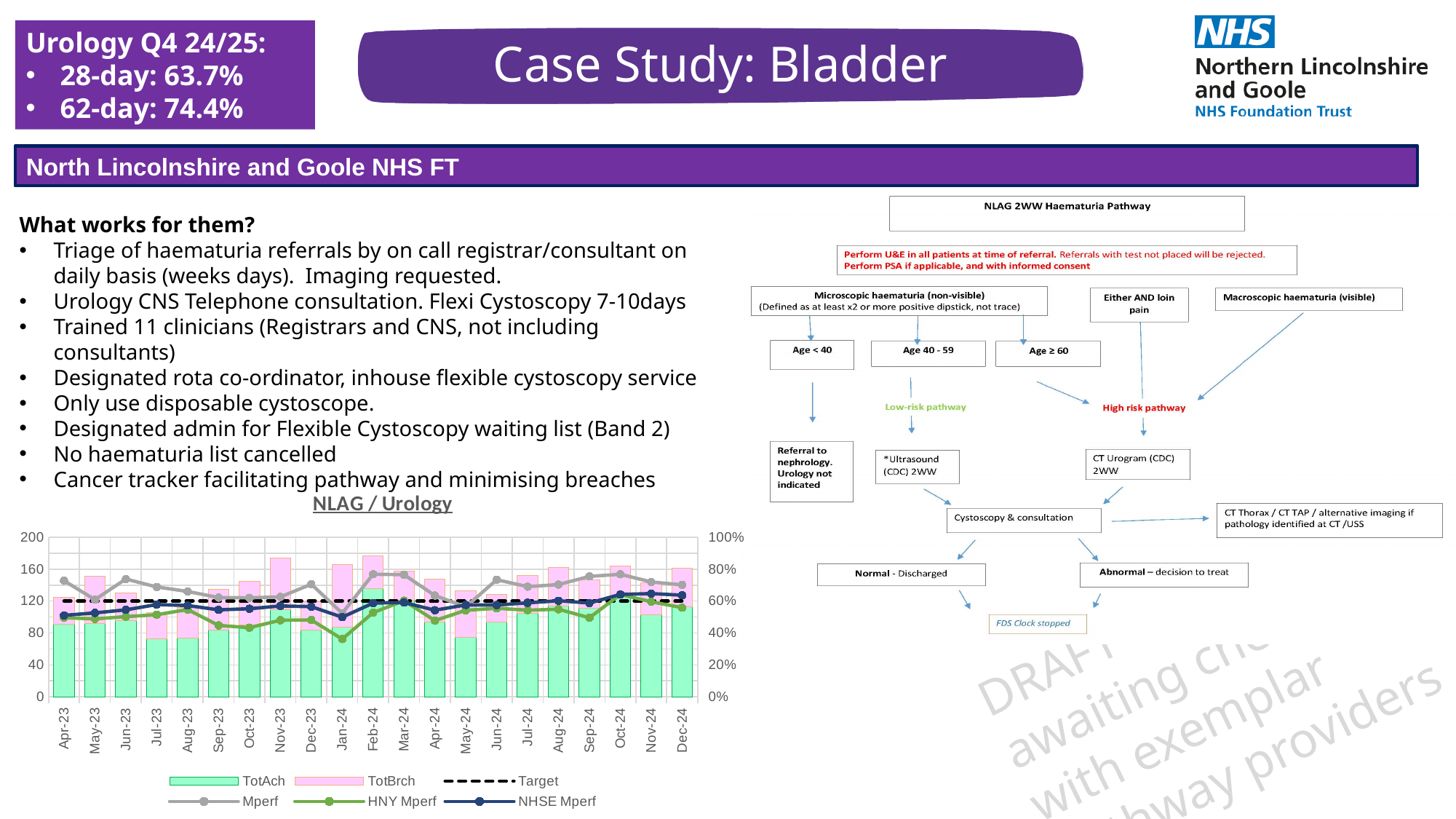
Which month is the last category on the x axis of the NLAG / Urology chart? Dec-24 How is the Target series drawn in the NLAG / Urology chart? As a black dashed line Is the total stacked bar (TotAch plus TotBrch) for Nov-23 greater or less than 160? greater How many months are shown on the x axis of the NLAG / Urology chart? 21 Is the Mperf value for Apr-23 greater or less than 60%? greater Is the HNY Mperf value for Jan-24 greater or less than 60%? less How many series does the legend of the NLAG / Urology chart list? 6 Which month is the first category on the x axis of the NLAG / Urology chart? Apr-23 What is the title of the chart on the slide? NLAG / Urology What kind of chart is the NLAG / Urology chart? A combined bar and line chart In Jan-24, which is larger: the Mperf value or the HNY Mperf value? Mperf